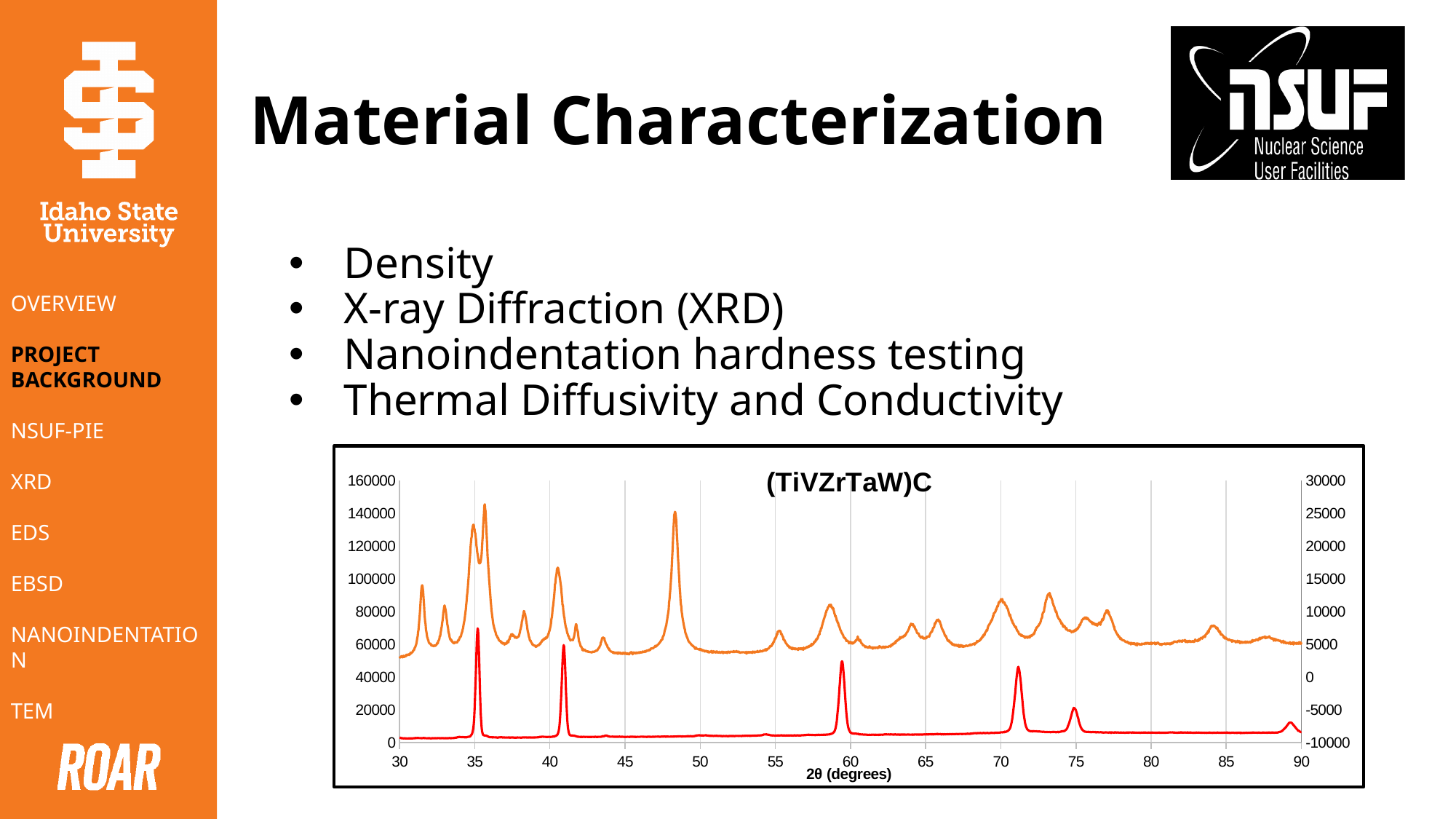
Near which x-axis tick does the red line reach its tallest peak? 35 What is the highest 2θ value shown on the x axis of the chart? 90 Which red-line peak is taller: the one near 2θ = 35 or the one near 2θ = 75? the one near 35 Reading against the left axis, is the red line's peak near 2θ = 59 greater or less than 60000? less What is the label of the x axis of the chart? 2θ (degrees) Reading against the left axis, is the orange line's peak near 2θ = 35 greater or less than 120000? greater What kind of chart is shown on the slide? line chart Reading against the left axis, is the red line's peak near 2θ = 35 greater or less than 60000? greater How many lines (series) are plotted on the chart? 2 What is the lowest value shown on the right y axis of the chart? -10000 What is the highest value shown on the left y axis of the chart? 160000 What is the title of the chart on the slide? (TiVZrTaW)C